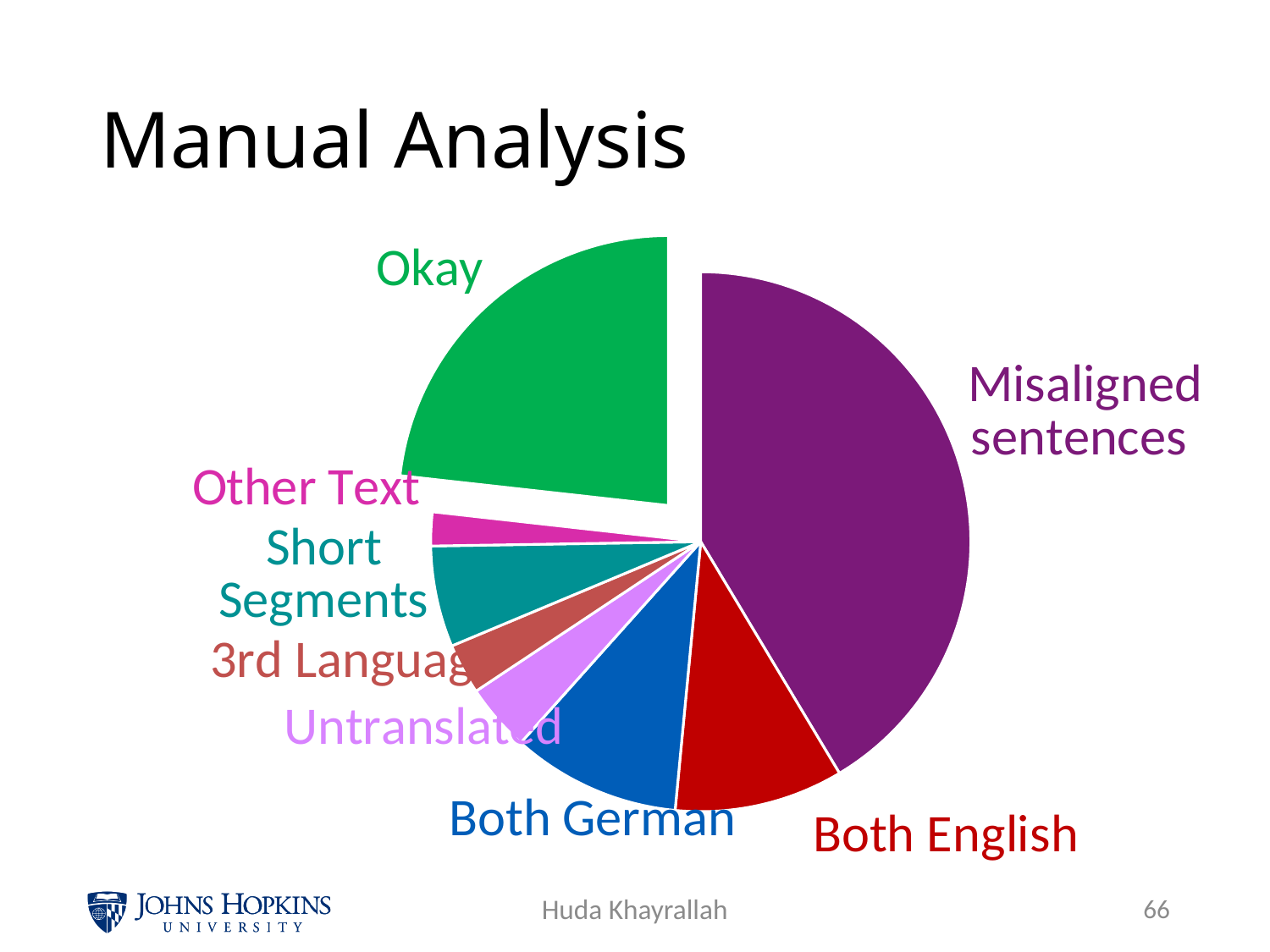
Which slice is larger, Both German or Untranslated? Both German How many slices does the pie chart have? 8 Which category has the largest slice of the pie? Misaligned sentences Which slice is larger, Okay or Both English? Okay Which slice is larger, Short Segments or 3rd Language? Short Segments What colour is the Okay slice of the pie chart? green Which category has the smallest slice of the pie? Other Text What kind of chart is shown on the slide? pie chart What is the title of the slide containing the pie chart? Manual Analysis